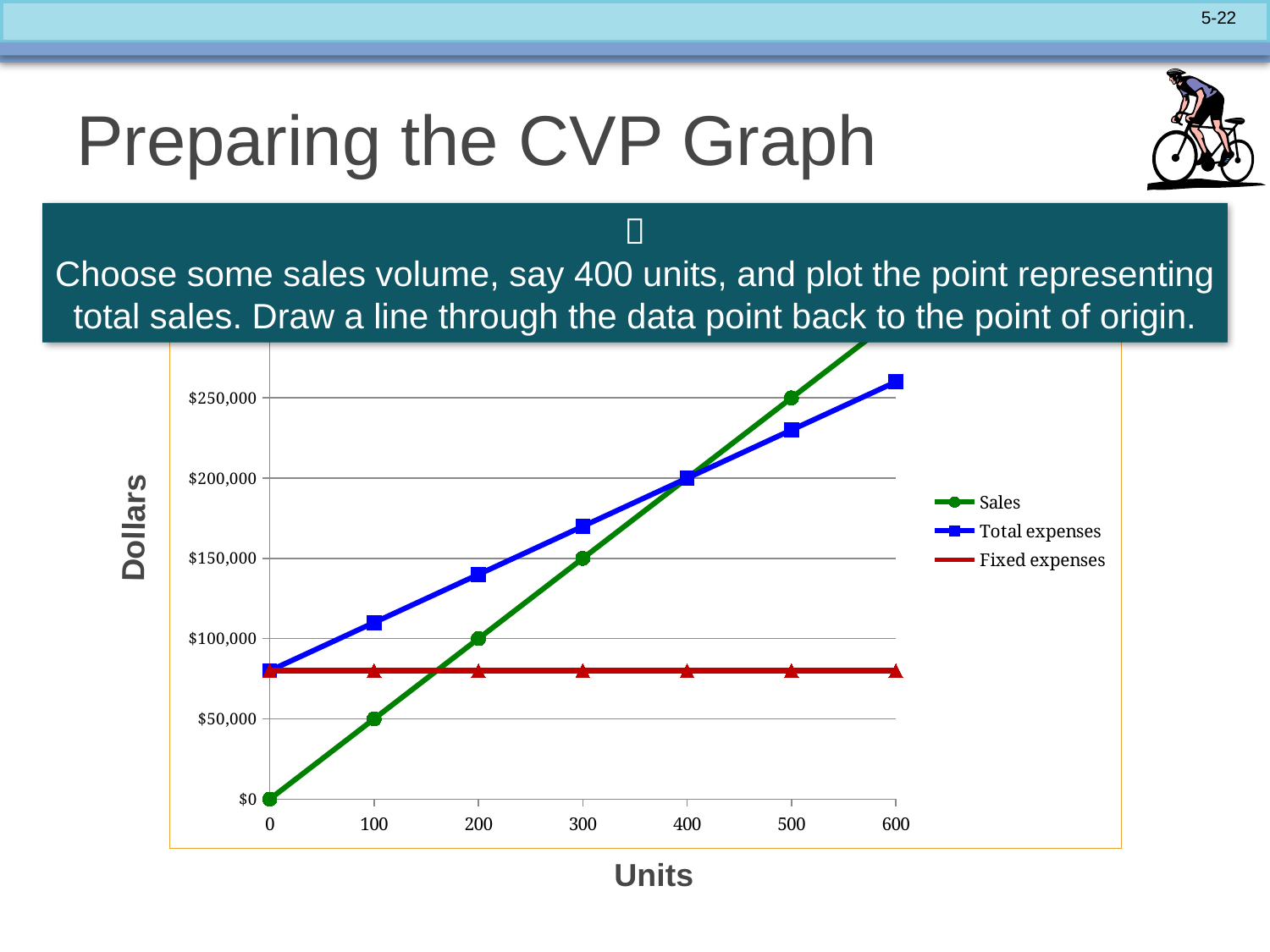
How many series does the legend list? 3 What are the three series named in the legend? Sales, Total expenses, Fixed expenses At 200 units, which is larger: Sales or Total expenses? Total expenses What is the difference between Sales at 400 units and Sales at 200 units? $100,000 What is the value of Sales at 200 units? $100,000 Is the value of Total expenses at 600 units greater or less than $250,000? greater What kind of chart is shown on the slide? line chart Is the value of Fixed expenses greater or less than $100,000? less What is the title of the horizontal axis? Units What is the value of Sales at 400 units? $200,000 Does the Sales line rise or fall as units increase? rise What is the value of Sales at 500 units? $250,000